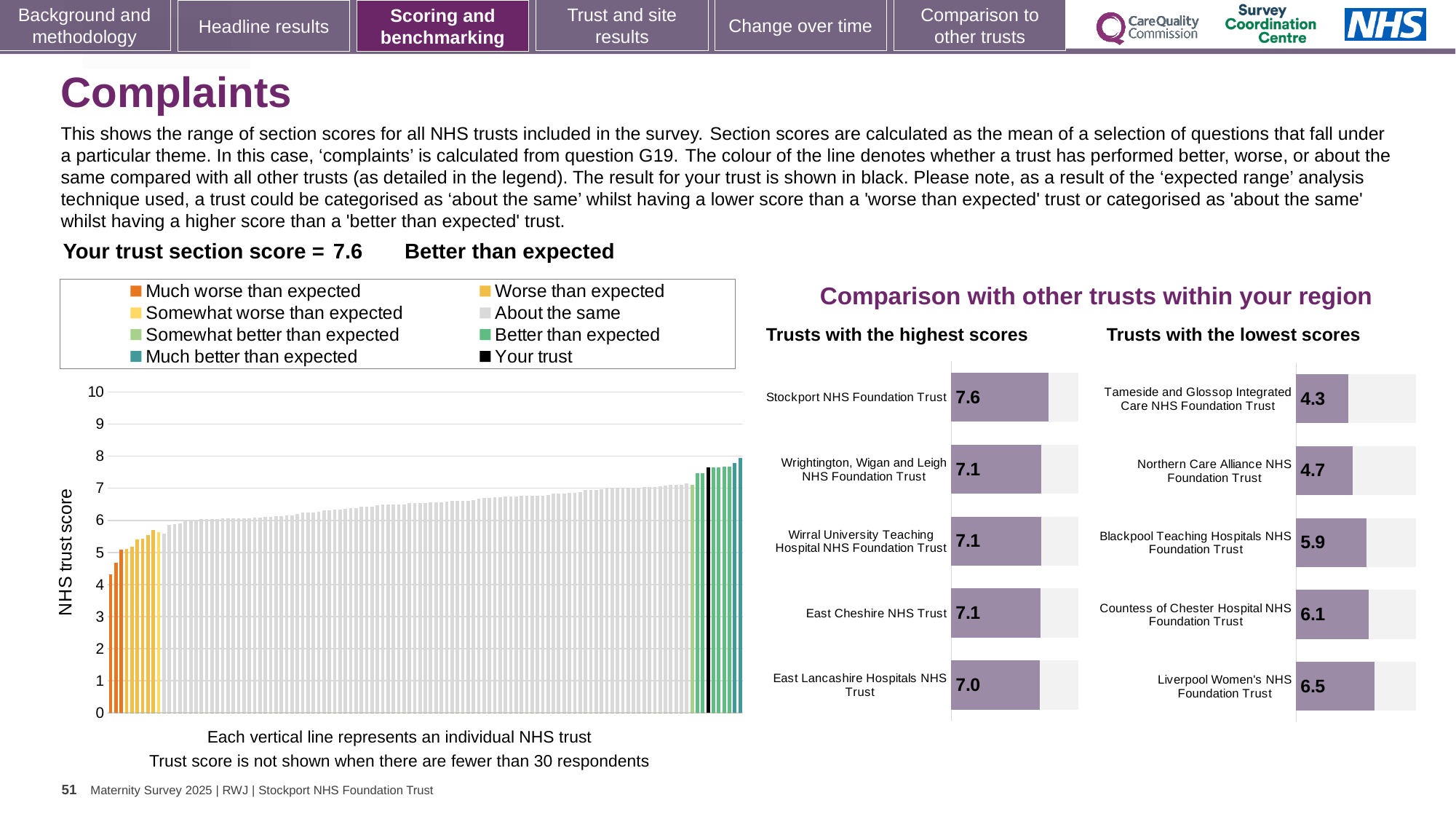
How many entries does the legend of the NHS trust score chart list? 8 In the 'Trusts with the lowest scores' chart, which trust has the highest score? Liverpool Women's NHS Foundation Trust In the 'Trusts with the highest scores' chart, what is the score for Stockport NHS Foundation Trust? 7.6 In the NHS trust score chart on the left, is the value of the leftmost bar greater or less than 5? less In the 'Trusts with the lowest scores' chart, how much higher is Liverpool Women's NHS Foundation Trust's score than Tameside and Glossop Integrated Care NHS Foundation Trust's score? 2.2 In the 'Trusts with the lowest scores' chart, which has the larger score: Blackpool Teaching Hospitals NHS Foundation Trust or Northern Care Alliance NHS Foundation Trust? Blackpool Teaching Hospitals NHS Foundation Trust In the 'Trusts with the highest scores' chart, what is the difference between the scores of Stockport NHS Foundation Trust and East Lancashire Hospitals NHS Trust? 0.6 In the NHS trust score chart on the left, do the bar values rise or fall from left to right? Rise How many trusts are shown in the 'Trusts with the highest scores' chart? 5 What kind of chart is the NHS trust score chart on the left? Bar chart In the 'Trusts with the lowest scores' chart, which trust has the lowest score? Tameside and Glossop Integrated Care NHS Foundation Trust In the 'Trusts with the lowest scores' chart, what is the score for Tameside and Glossop Integrated Care NHS Foundation Trust? 4.3